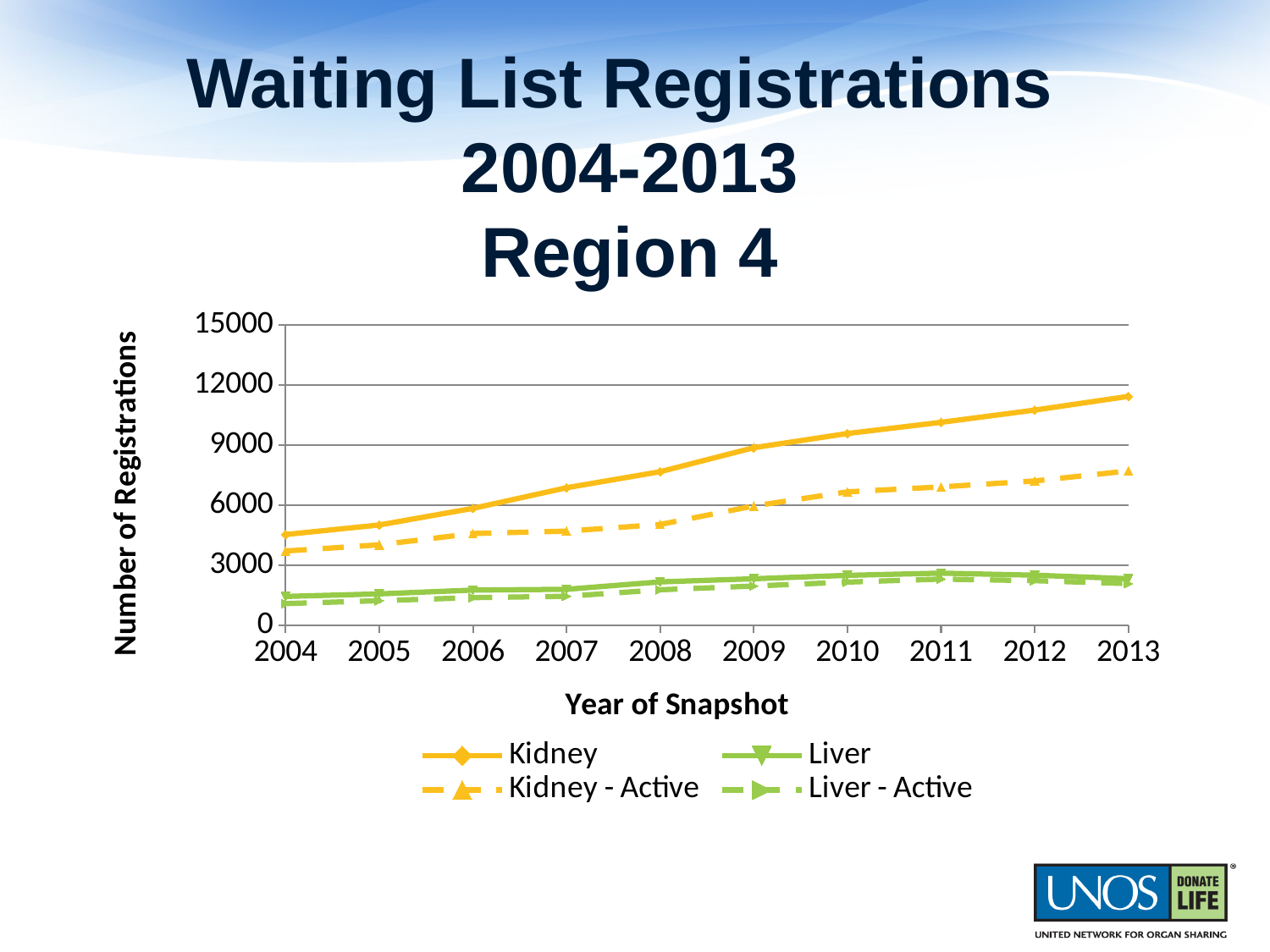
Which series has the highest value in 2013? Kidney How many years are plotted along the x axis? 10 What is the label of the y axis? Number of Registrations Which is larger in 2010, the Kidney value or the Kidney - Active value? Kidney Do the Kidney values rise or fall from 2004 to 2013? rise Which series has the lowest value in 2013? Liver - Active Is the Kidney value for 2004 greater or less than 6000? less Is the Kidney value for 2013 greater or less than 9000? greater Is the Kidney - Active value for 2013 greater or less than 6000? greater How many series does the legend list? 4 What kind of chart is shown on the slide? line chart